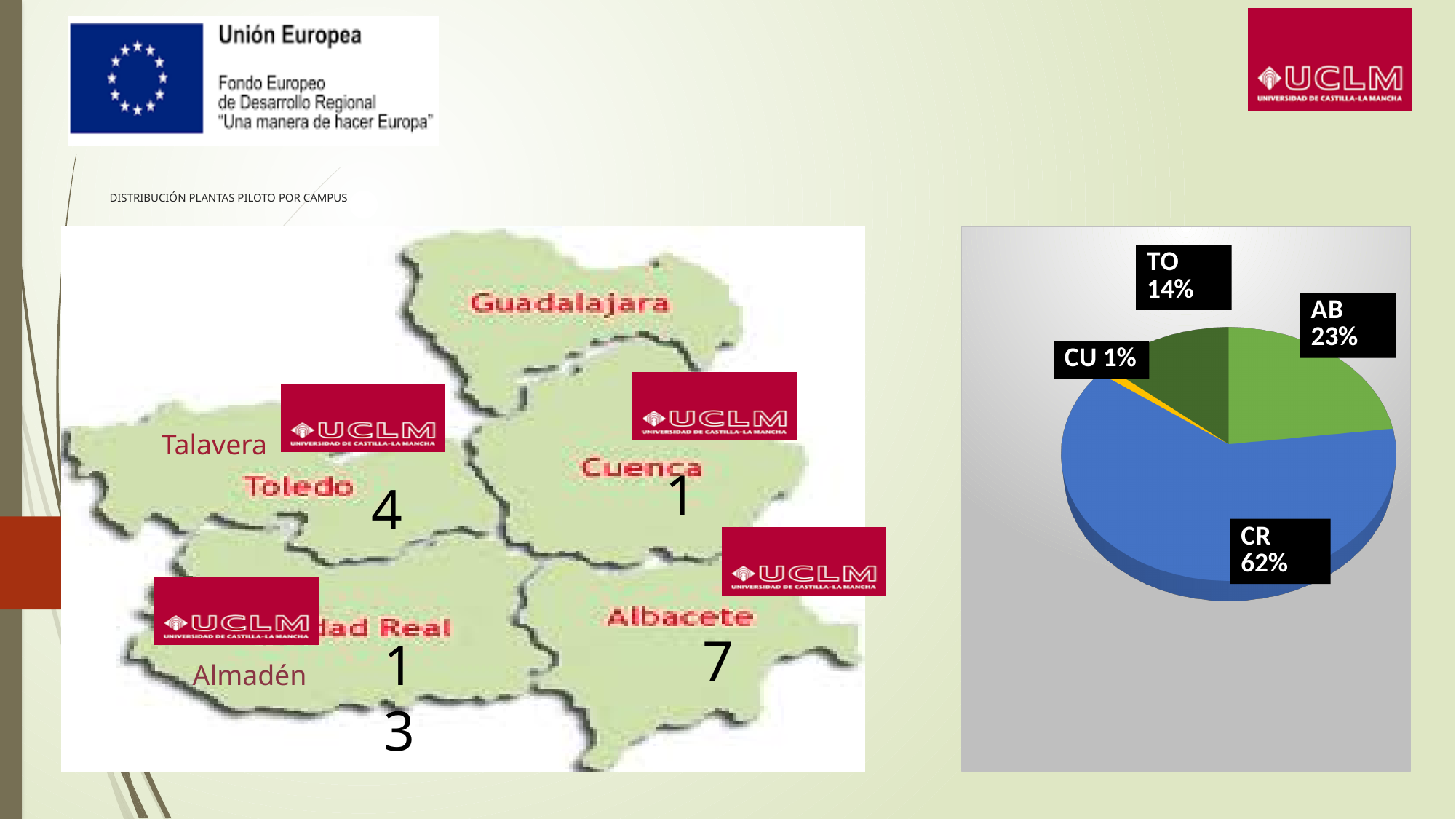
In the pie chart, what share does TO have? 14% How many slices does the pie chart have? 4 In the pie chart, what share does CR have? 62% In the pie chart, what share does AB have? 23% In the pie chart, what colour is the CR slice? blue Which slice of the pie chart is the smallest? CU In the pie chart, which is larger, AB or TO? AB What kind of chart is shown on the right side of the slide? pie chart Which slice of the pie chart is the largest? CR In the pie chart, what is the difference between the CR share and the AB share? 39% In the pie chart, what share does CU have? 1% In the pie chart, what is the combined share of TO and CU? 15%